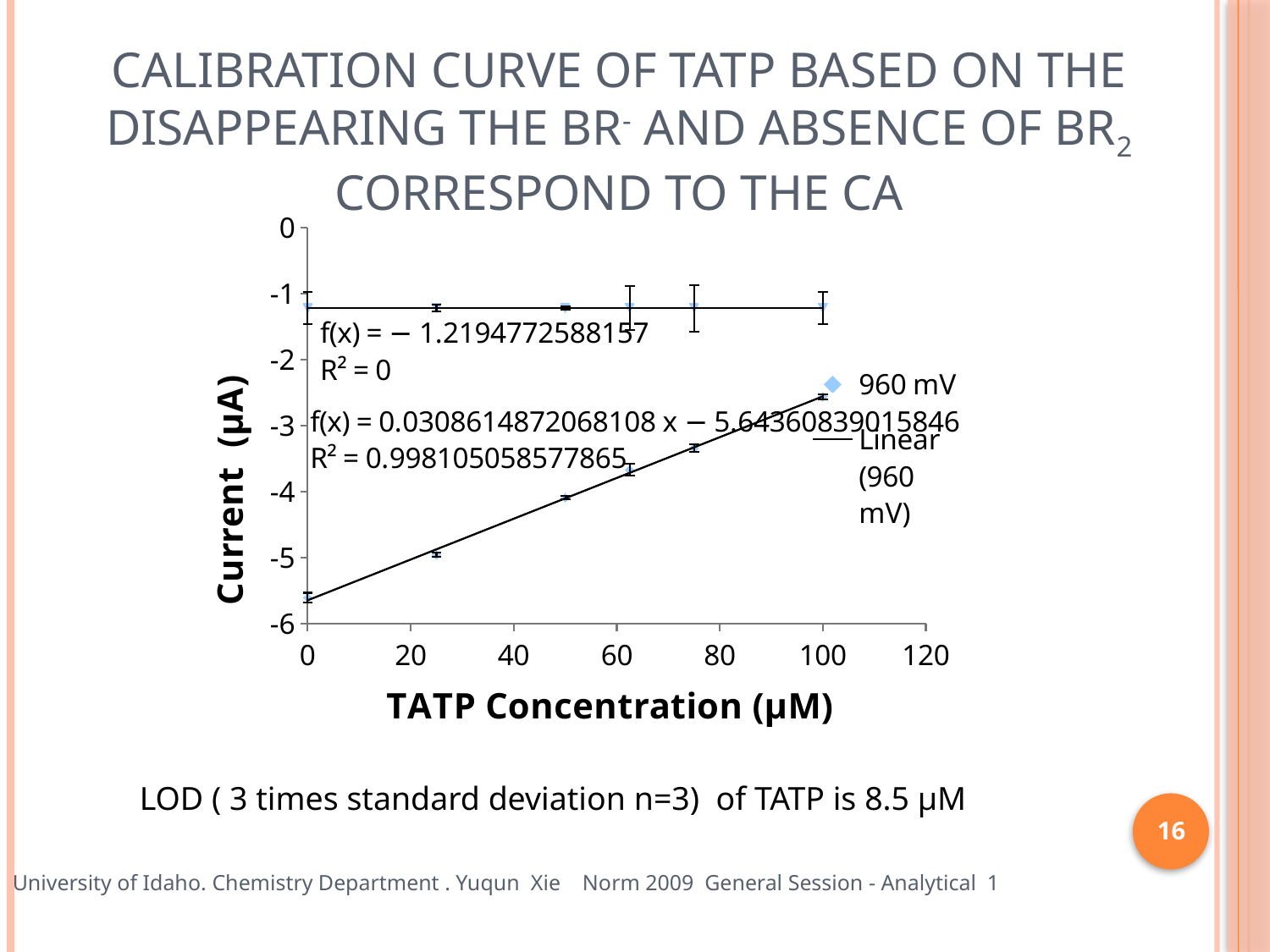
What R² value is shown for the flat fit f(x) = −1.2194772588157? 0 Does the current of the rising 960 mV series increase or decrease as TATP concentration increases? increase What is the slope of the rising linear fit equation shown on the chart? 0.0308614872068108 What kind of chart is shown on the slide? scatter chart Which has the higher current on the rising series: the point at 0 µM or the point at 100 µM TATP? 100 µM Is the current of the rising series at 100 µM TATP greater or less than -3 µA? greater What are the two entries in the chart legend? 960 mV and Linear (960 mV) How many entries does the chart legend list? 2 What is the intercept of the rising linear fit equation f(x) = 0.0308614872068108 x − ... shown on the chart? −5.64360839015846 What R² value is shown for the rising linear fit on the chart? 0.998105058577865 Is the current of the rising series at 0 µM TATP greater or less than -5 µA? less What is the title of the x axis of the chart? TATP Concentration (µM)